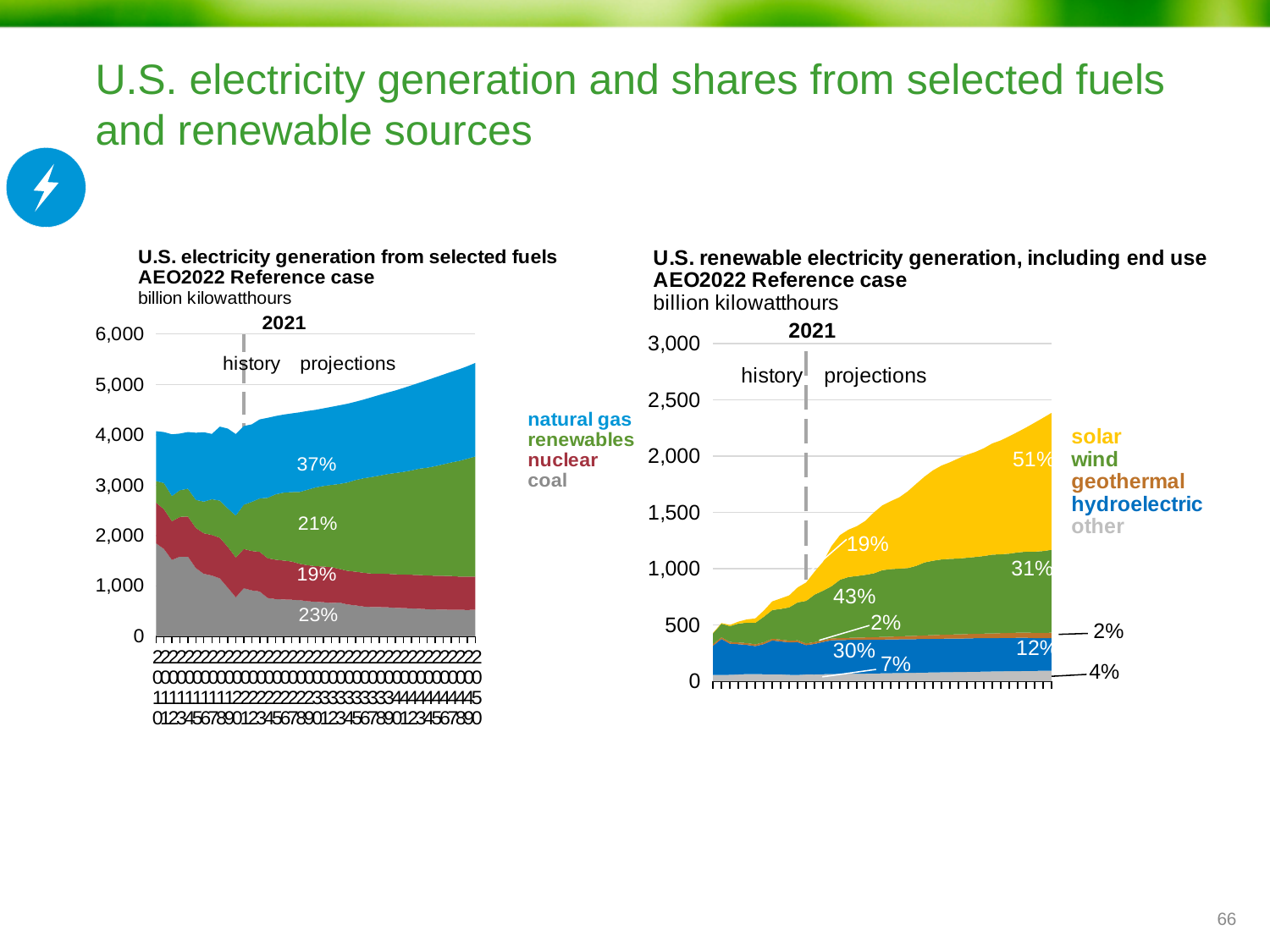
In the left chart, 'U.S. electricity generation from selected fuels', what percentage label is shown on the nuclear area? 19% In the left chart, 'U.S. electricity generation from selected fuels', what percentage label is shown on the coal area? 23% In the right chart, 'U.S. renewable electricity generation, including end use', does total renewable generation rise or fall over the projection period? rise How many series does the legend of the right chart, 'U.S. renewable electricity generation, including end use', list? 5 In the right chart, 'U.S. renewable electricity generation, including end use', which series has the larger percentage label at the right end of the projections, solar or wind? solar In the right chart, 'U.S. renewable electricity generation, including end use', what percentage label is shown for solar at the right end of the projections? 51% In the right chart, 'U.S. renewable electricity generation, including end use', what percentage label is shown for hydroelectric at the right end of the projections? 12% In the right chart, 'U.S. renewable electricity generation, including end use', is the total renewable generation at the right end of the projections greater or less than 2,000 billion kilowatthours? greater What kind of chart is the left chart, 'U.S. electricity generation from selected fuels'? stacked area chart In the right chart, 'U.S. renewable electricity generation, including end use', what percentage label is shown for wind near the 2021 line? 43% How many series does the legend of the left chart, 'U.S. electricity generation from selected fuels', list? 4 In the left chart, 'U.S. electricity generation from selected fuels', what percentage label is shown on the natural gas area? 37%